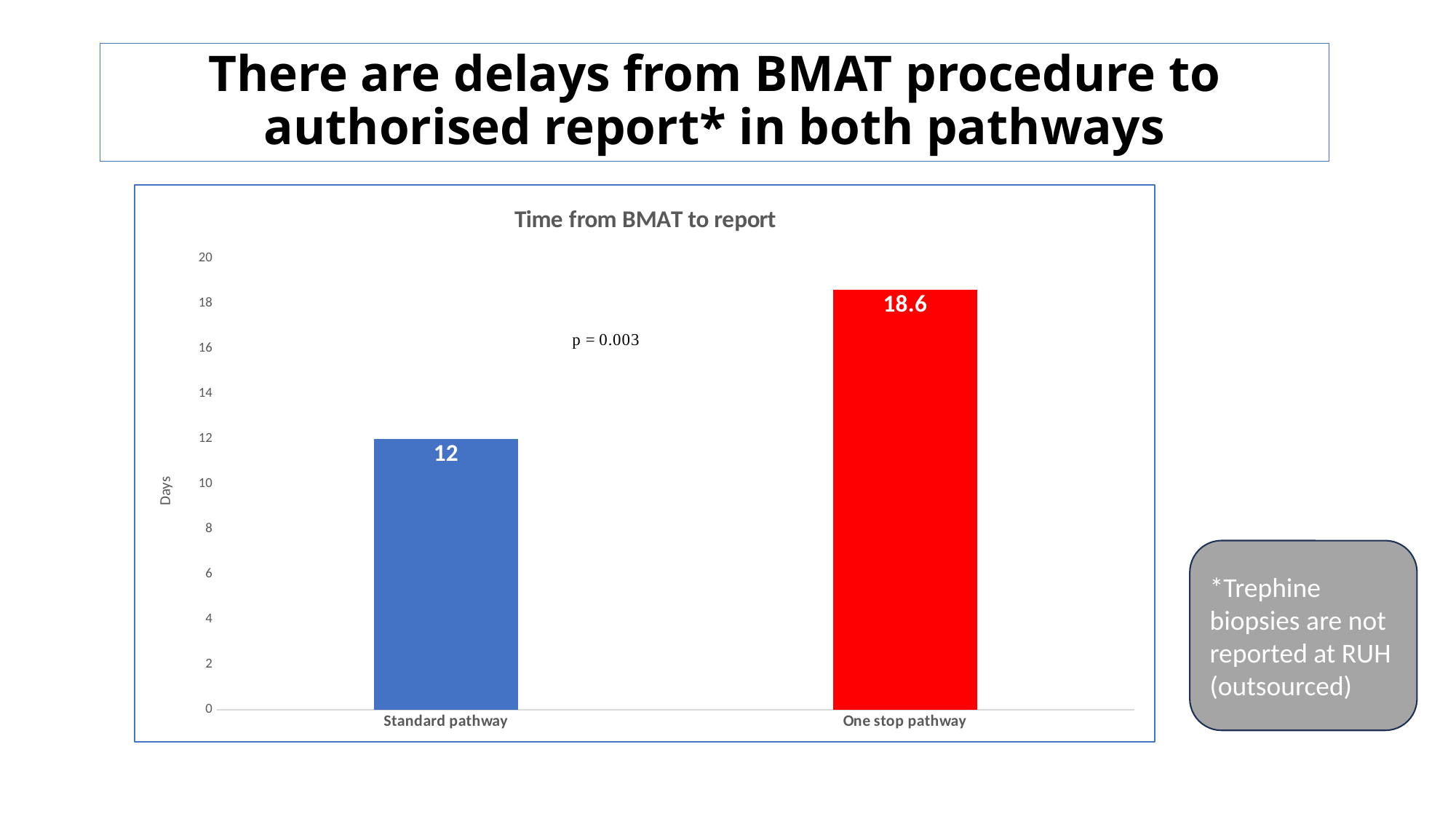
Which pathway has the lowest time from BMAT to report? Standard pathway What is the title of the chart? Time from BMAT to report Is the value for One stop pathway greater or less than 16? greater What is the difference between the One stop pathway and Standard pathway values? 6.6 What is the value for One stop pathway? 18.6 What is the value for Standard pathway? 12 Which is larger, the value for Standard pathway or One stop pathway? One stop pathway What kind of chart is shown? Bar chart Is the value for Standard pathway greater or less than 14? less How many categories are shown on the chart? 2 What is the label of the vertical axis? Days Which pathway has the highest time from BMAT to report? One stop pathway